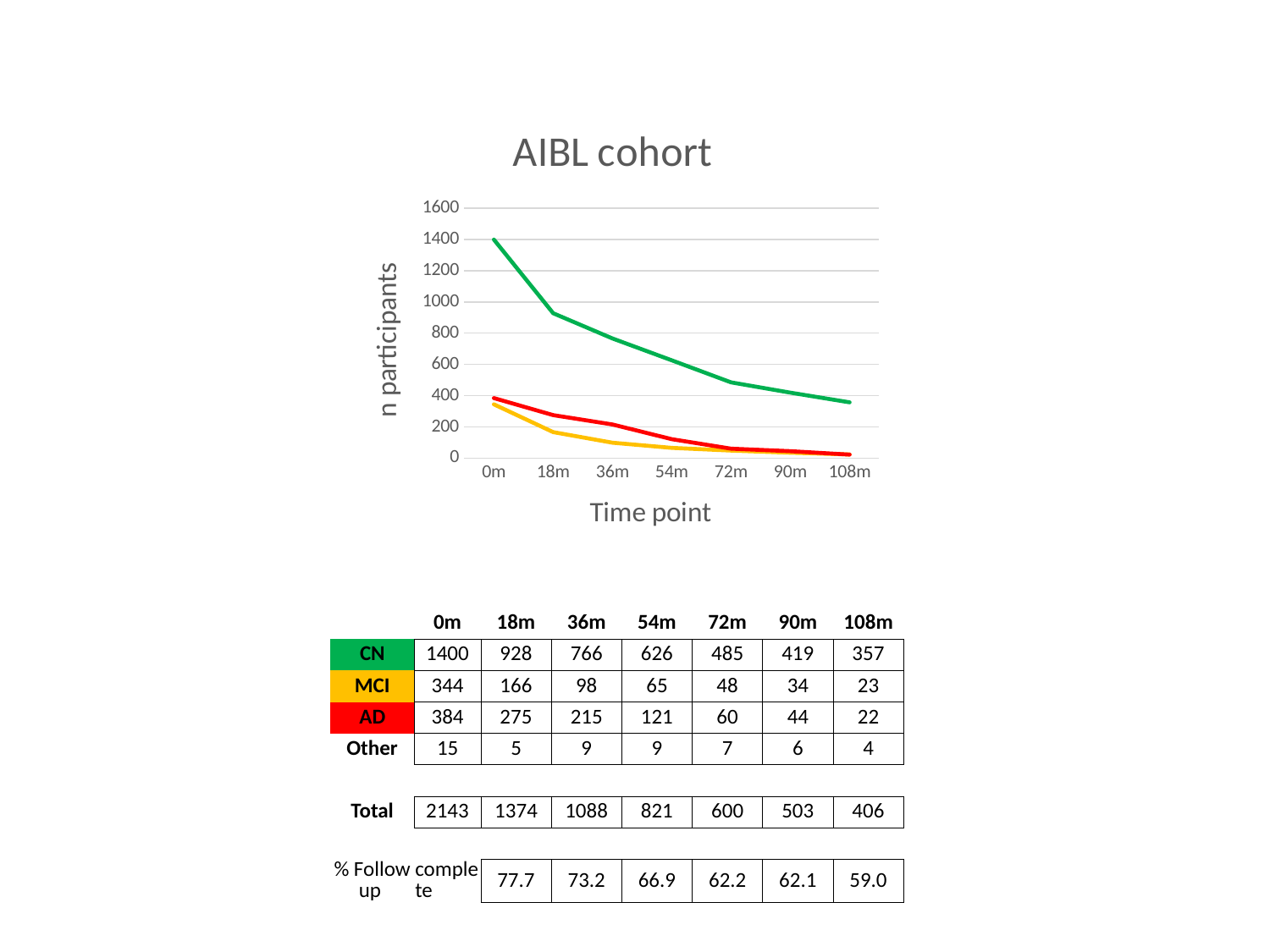
What is the number of CN participants at 0m? 1400 What is the number of MCI participants at 108m? 23 What is the difference between CN participants at 0m and at 18m? 472 Which group has the highest number of participants at 18m? CN What type of chart is shown on the slide? line chart What is the title of the chart? AIBL cohort What is the number of AD participants at 36m? 215 Does the number of CN participants rise or fall from 0m to 108m? fall How many time points are plotted along the x axis of the chart? 7 How many lines are plotted in the chart? 3 At 0m, which group has more participants, MCI or AD? AD